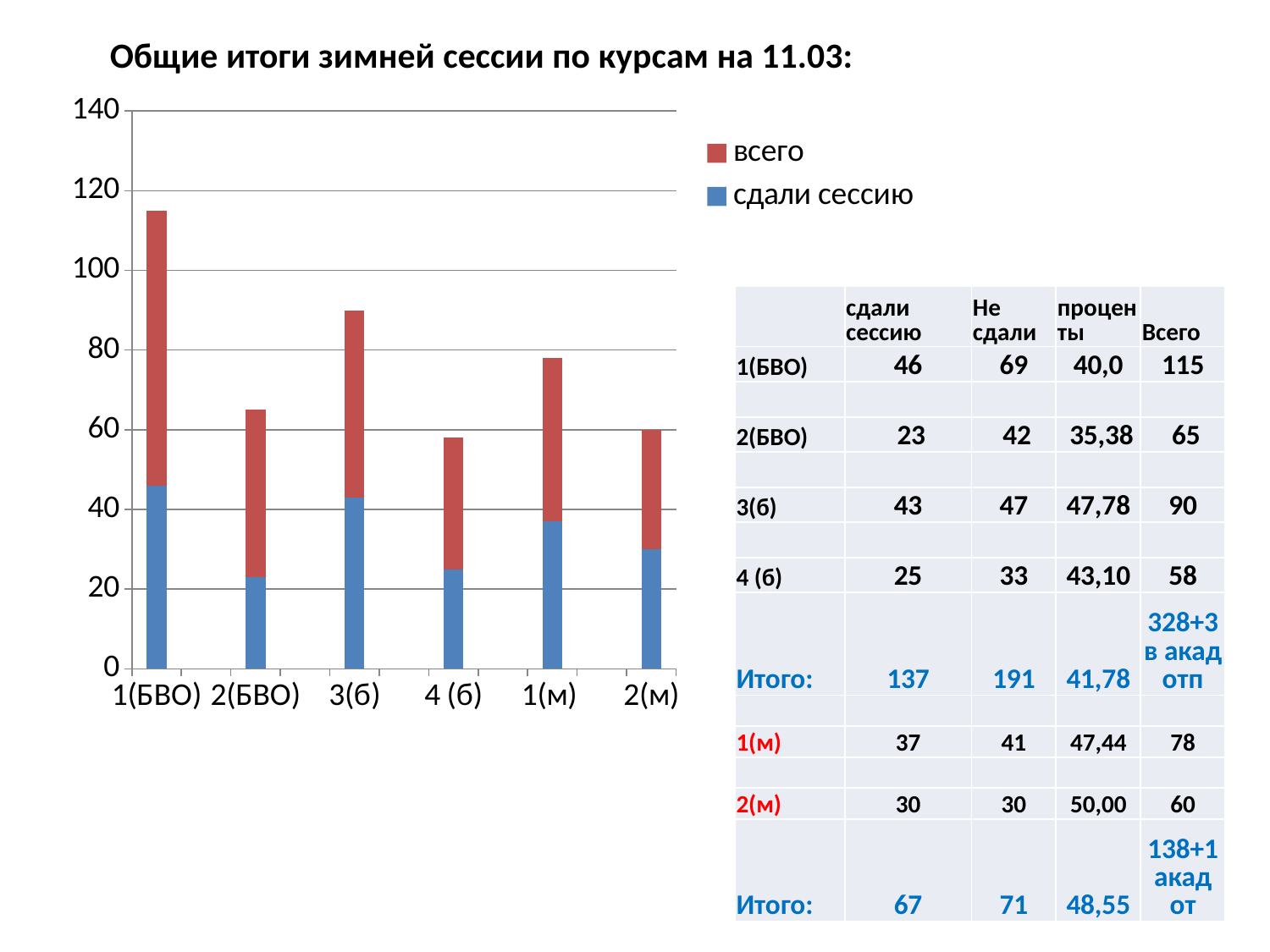
What colour represents сдали сессию in the chart? blue How many categories are shown on the x axis of the chart? 6 Which is larger, the всего value for 3(б) or the всего value for 1(м)? 3(б) Which is larger, the сдали сессию value for 1(БВО) or for 2(БВО)? 1(БВО) What is the всего value for 1(БВО)? 115 What kind of chart is shown on the slide? bar chart Is the value for всего for 3(б) greater or less than 100? less Which category has the highest value for всего? 1(БВО) How many series does the chart legend list? 2 Is the value for всего for 1(БВО) greater or less than 100? greater Is the value for сдали сессию for 4 (б) greater or less than 40? less What is the сдали сессию value for 3(б)? 43